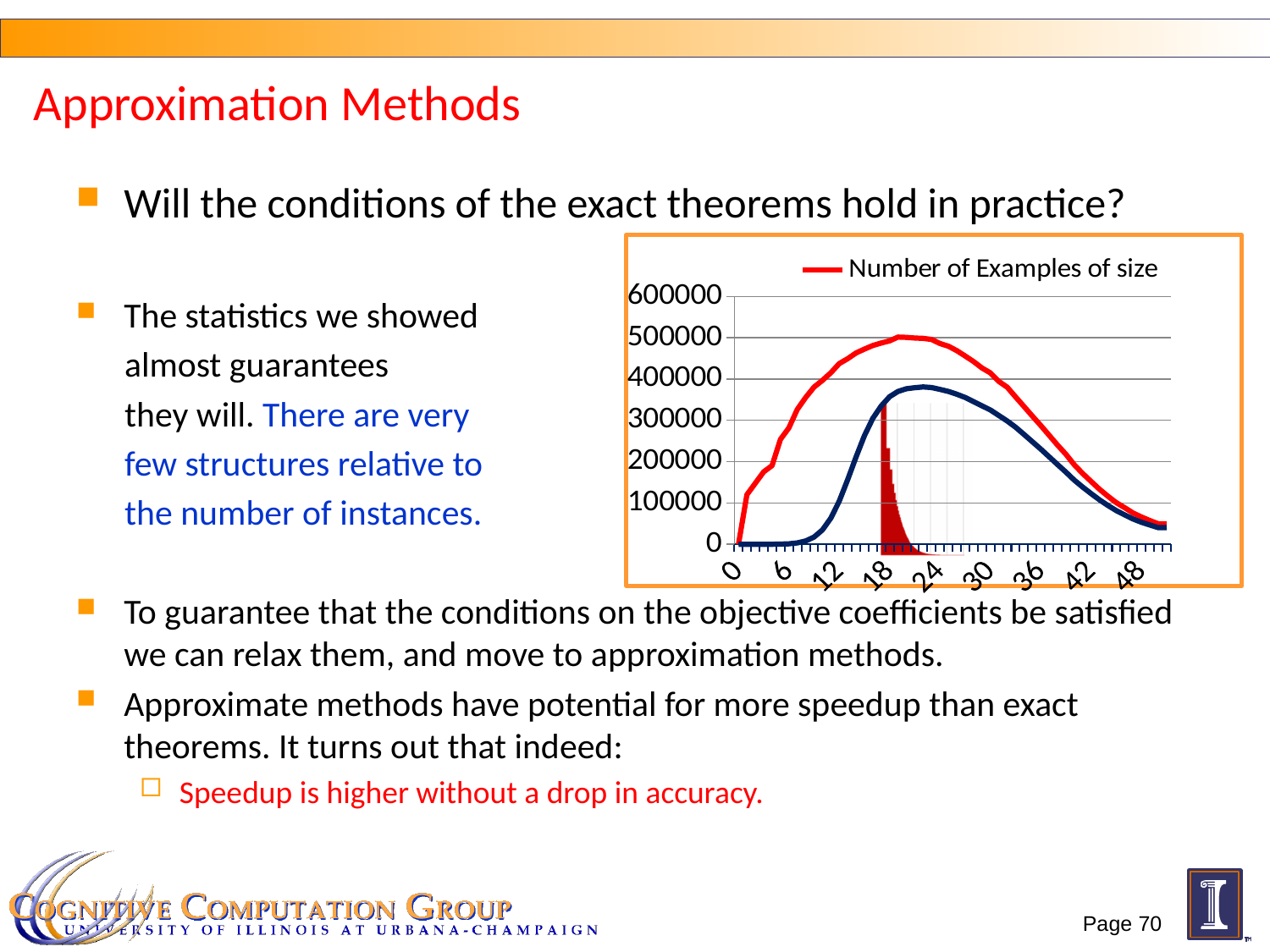
What kind of chart is shown on the slide? line chart Does the red line rise or fall as x goes from 24 to 48? fall What series name does the chart's legend show? Number of Examples of size Is the value of the red line at x = 12 greater or less than 400000? greater What is the highest value labelled on the chart's vertical axis? 600000 At x = 12, which line has the larger value, the red line or the dark blue line? the red line Is the value of the red line at x = 48 greater or less than 100000? less Is the value of the red line at x = 24 greater or less than 400000? greater How many tick labels are printed on the chart's horizontal axis? 9 Does the red line rise or fall as x goes from 0 to 12? rise